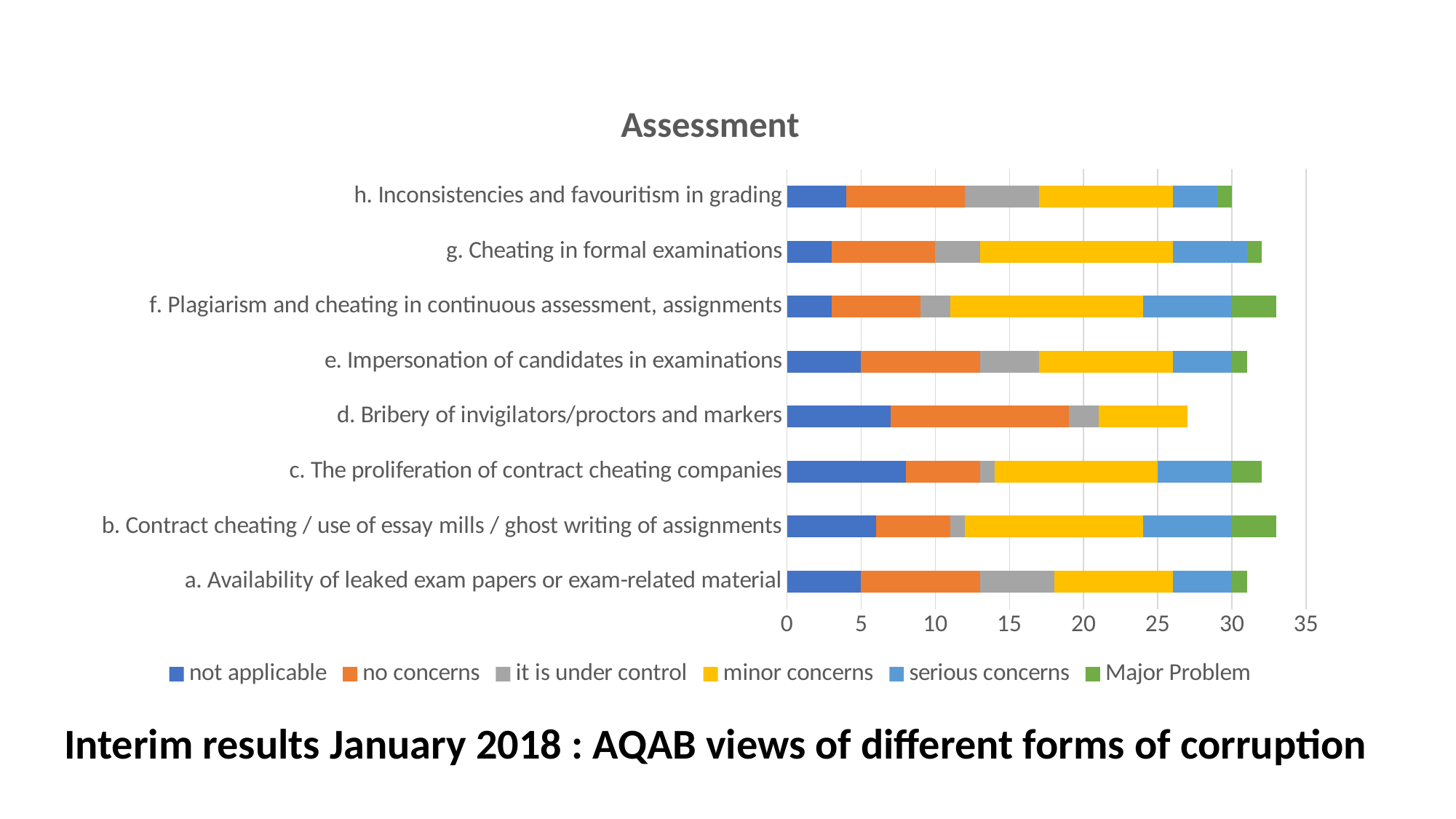
Which has the larger total bar: 'd. Bribery of invigilators/proctors and markers' or 'f. Plagiarism and cheating in continuous assessment, assignments'? f. Plagiarism and cheating in continuous assessment, assignments What is the title of the chart? Assessment Which category has the shortest total bar? d. Bribery of invigilators/proctors and markers Which has the larger 'not applicable' value: 'c. The proliferation of contract cheating companies' or 'g. Cheating in formal examinations'? c. The proliferation of contract cheating companies How many categories (forms of corruption) are plotted on the chart? 8 What kind of chart is shown on the slide? Stacked bar chart Is the total bar length for 'f. Plagiarism and cheating in continuous assessment, assignments' greater or less than 30? greater Which colour represents 'minor concerns' in the legend? Yellow Is the 'not applicable' value for 'g. Cheating in formal examinations' greater or less than 5? less Is the total bar length for 'd. Bribery of invigilators/proctors and markers' greater or less than 30? less How many series does the legend list? 6